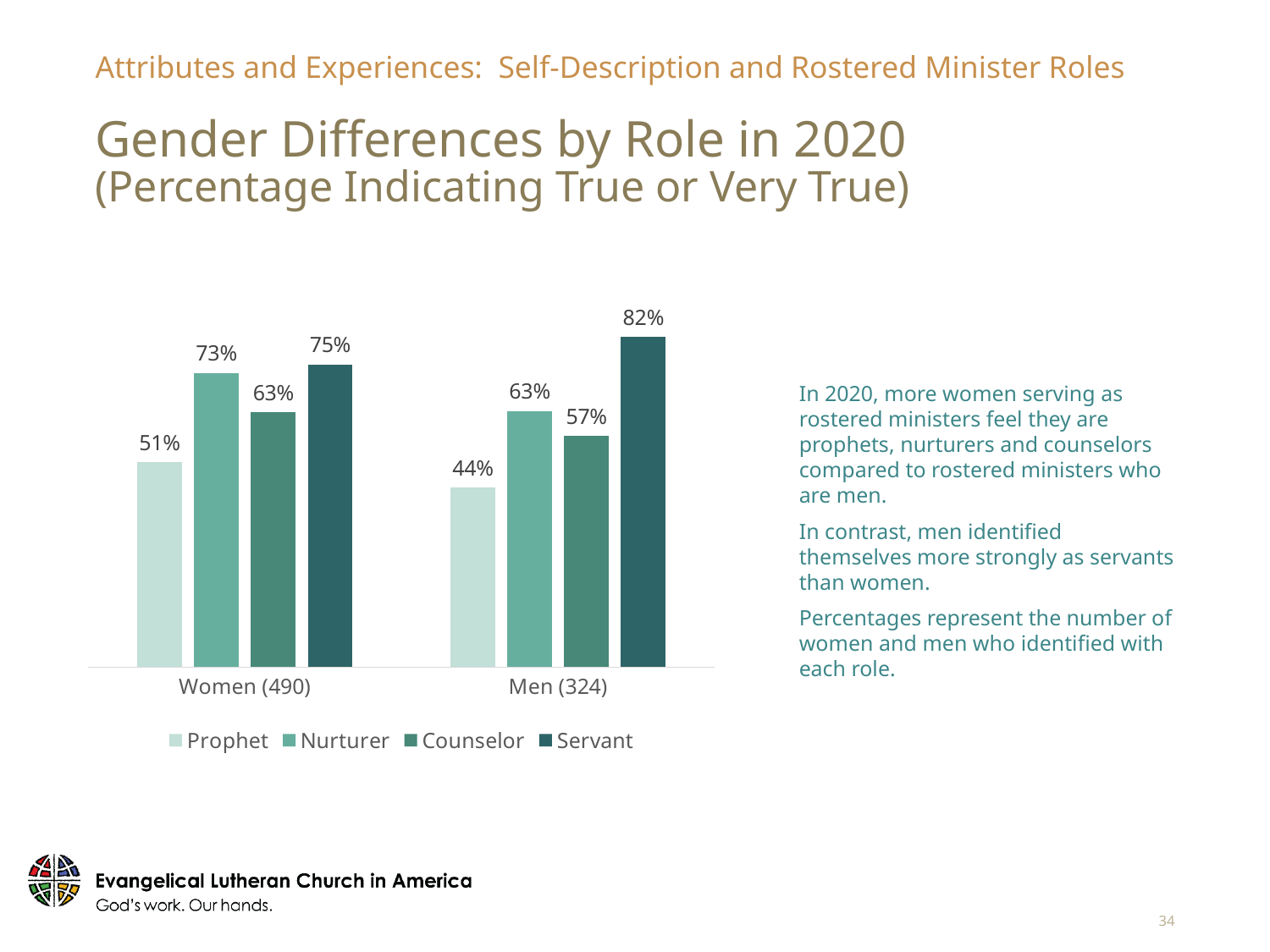
Which is larger, the Counselor value for women or the Counselor value for men? Women What kind of chart is shown on the slide? Bar chart What is the value for Servant among men? 82% What is the difference between the Servant values for men and women? 7 percentage points How many gender categories are shown on the x axis? 2 What is the difference between the Nurturer values for women and men? 10 percentage points How many women respondents are indicated in the x-axis label? 490 Which role has the lowest value for women? Prophet What percentage of women indicated the Prophet role was true or very true? 51% Which role has the highest value for men? Servant What is the value for Nurturer among women? 73% How many series does the legend list? 4